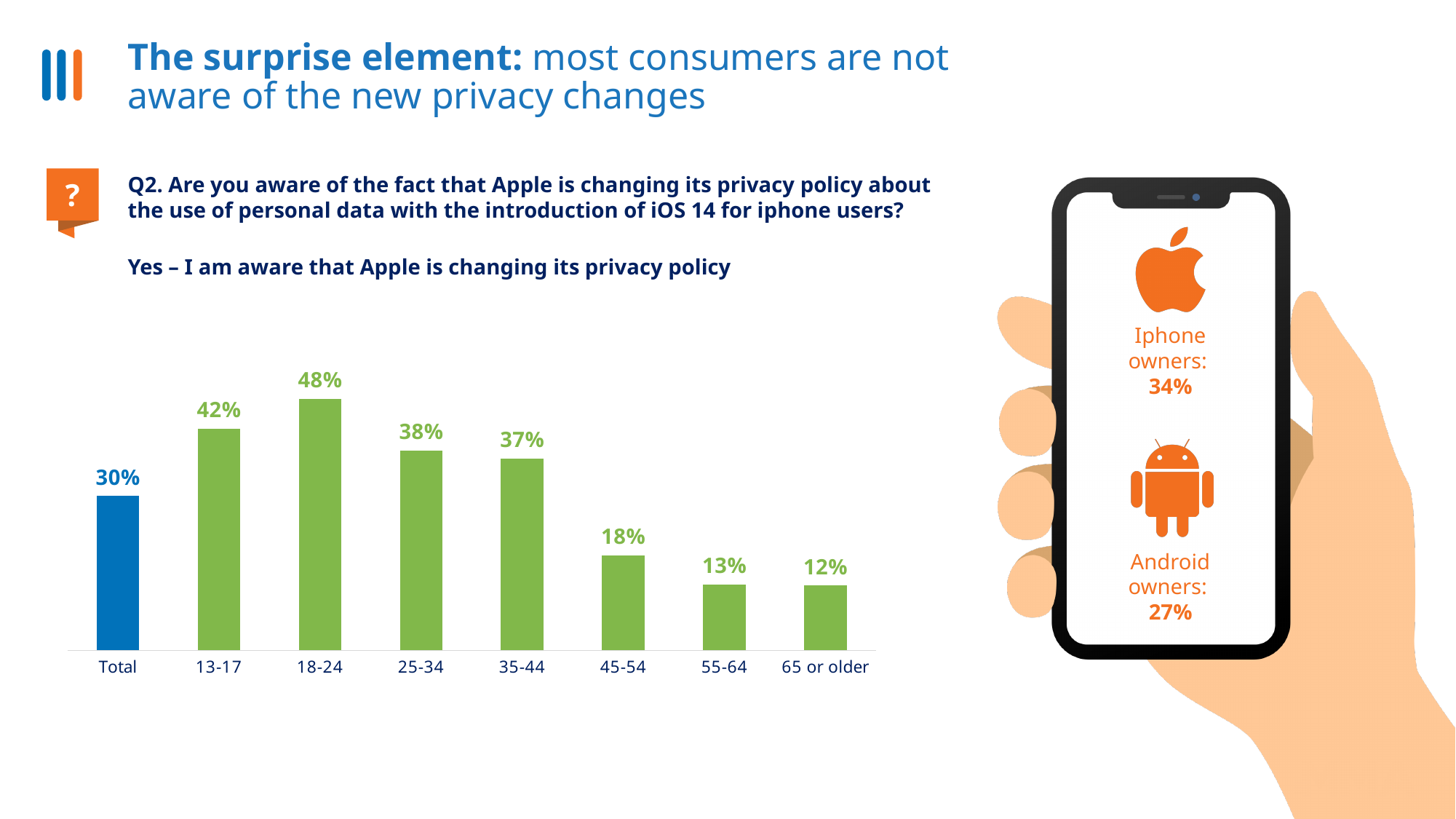
What kind of chart is shown on the slide? Bar chart What is the difference between the 18-24 value and the Total value? 18% Which is larger, the value for 25-34 or the value for 55-64? 25-34 What is the value for the 65 or older age group? 12% Which age group has the highest value? 18-24 What is the value for the 18-24 age group? 48% What is the value for the Total bar? 30% Which age group has the lowest value? 65 or older What is the difference between the values for 13-17 and 45-54? 24% How many bars are shown in the chart? 8 What colour is the Total bar? Blue Do the values rise or fall across the age groups from 18-24 to 65 or older? Fall